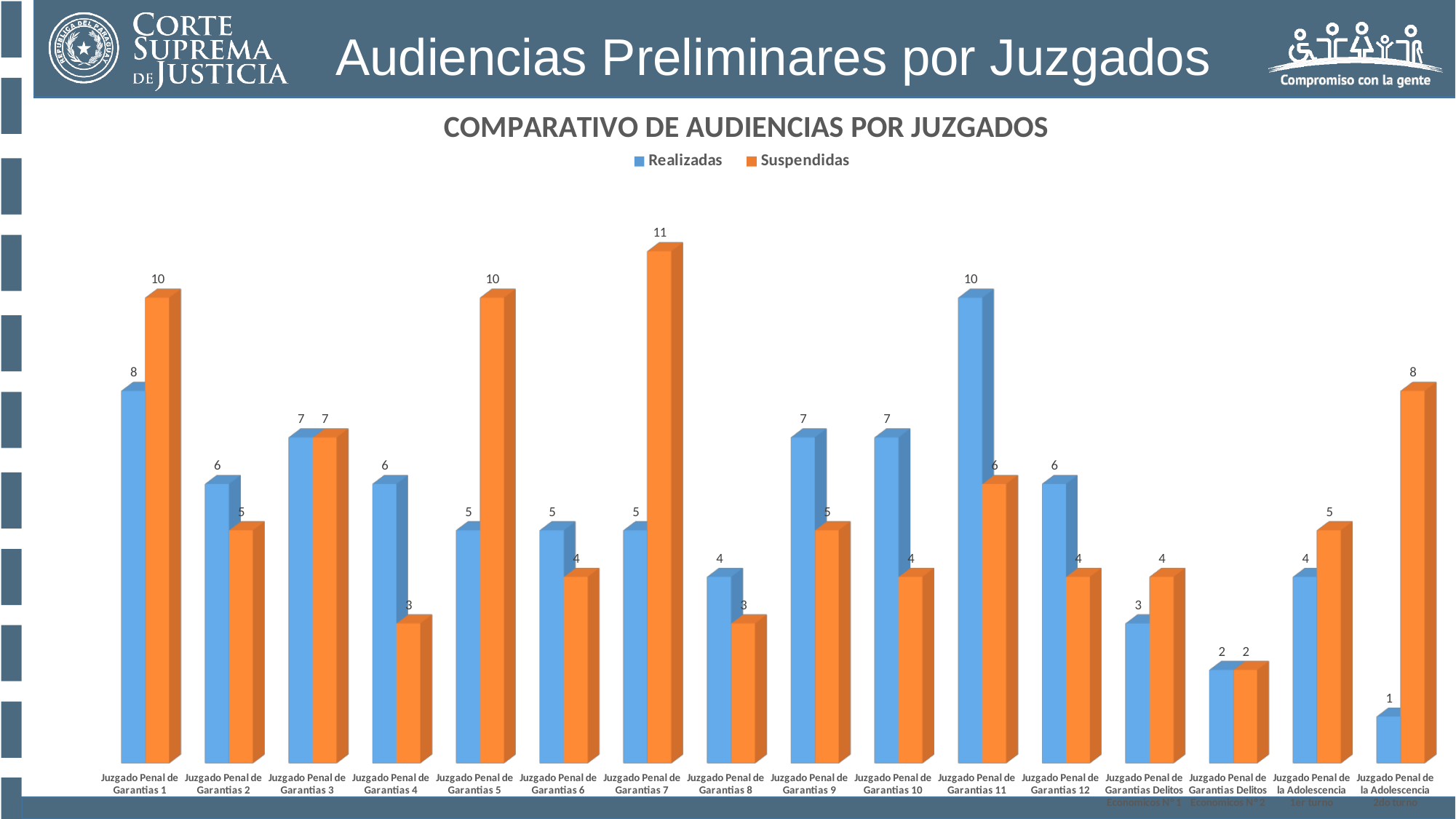
What is the title of the chart? COMPARATIVO DE AUDIENCIAS POR JUZGADOS What is the Suspendidas value for Juzgado Penal de Garantias 4? 3 Which juzgado has the highest Realizadas value? Juzgado Penal de Garantias 11 What is the Realizadas value for Juzgado Penal de Garantias 1? 8 How many juzgados (categories) are shown on the x axis? 16 Which juzgado has the highest Suspendidas value? Juzgado Penal de Garantias 7 For Juzgado Penal de Garantias 9, which is larger, Realizadas or Suspendidas? Realizadas What is the difference between Suspendidas and Realizadas for Juzgado Penal de Garantias 5? 5 How many series does the legend list? 2 What is the Suspendidas value for Juzgado Penal de Garantias 7? 11 What is the total of Realizadas and Suspendidas for Juzgado Penal de Garantias 3? 14 What type of chart is shown on the slide? bar chart